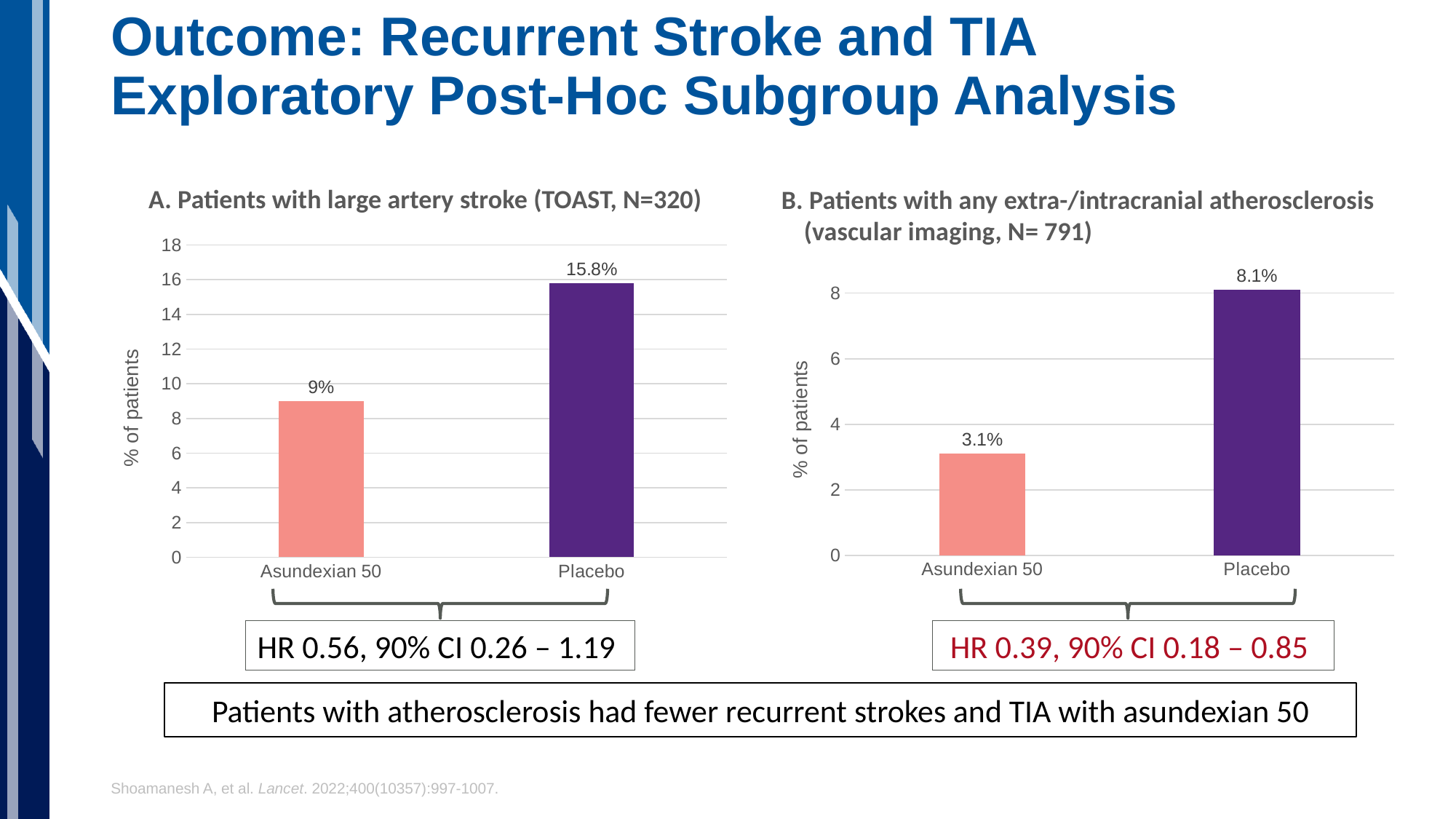
What kind of chart is chart B (Patients with any extra-/intracranial atherosclerosis)? Bar chart What is the y-axis label of chart A (Patients with large artery stroke)? % of patients In chart A (Patients with large artery stroke), what is the value for Placebo? 15.8% In chart B (Patients with any extra-/intracranial atherosclerosis), what is the value for Asundexian 50? 3.1% How many categories are shown in chart A (Patients with large artery stroke)? 2 In chart B (Patients with any extra-/intracranial atherosclerosis), which category has the lowest value? Asundexian 50 In chart B (Patients with any extra-/intracranial atherosclerosis), what is the value for Placebo? 8.1% In chart A (Patients with large artery stroke), what is the difference between the Placebo and Asundexian 50 values? 6.8% In chart A (Patients with large artery stroke), what is the value for Asundexian 50? 9% In chart B (Patients with any extra-/intracranial atherosclerosis), which is larger, Asundexian 50 or Placebo? Placebo In chart A (Patients with large artery stroke), which category has the highest value? Placebo In chart B (Patients with any extra-/intracranial atherosclerosis), what is the difference between the Placebo and Asundexian 50 values? 5%